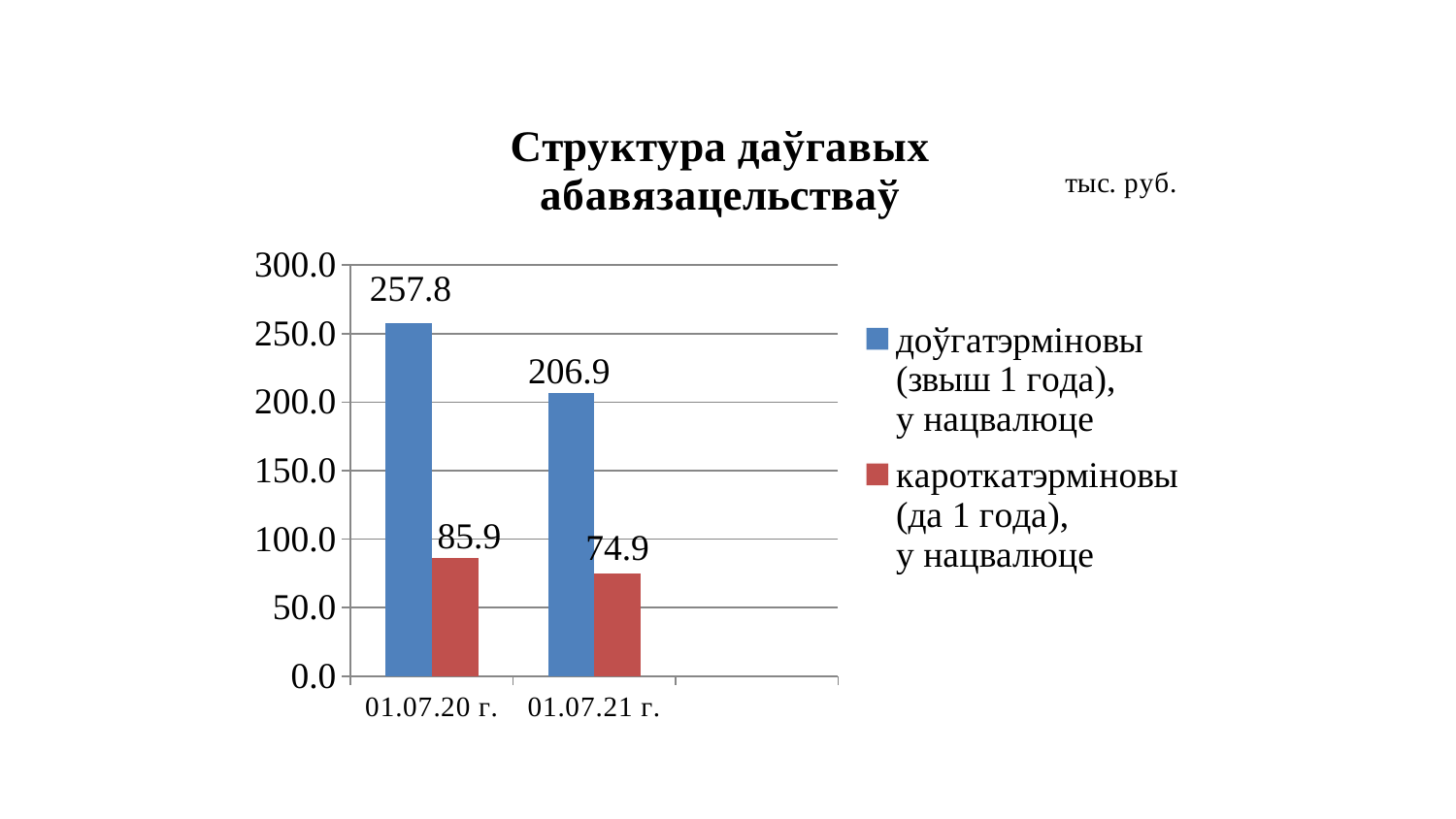
What kind of chart is shown on the slide? Bar chart What is the value of the short-term (кароткатэрміновы) series for 01.07.20 г.? 85.9 What unit is indicated next to the chart title? тыс. руб. Which date has the highest value for the long-term (доўгатэрміновы) series? 01.07.20 г. How many dates (categories) are shown on the x axis? 2 What is the difference between the long-term values for 01.07.20 г. and 01.07.21 г.? 50.9 How many series does the legend list? 2 What is the value of the long-term (доўгатэрміновы) series for 01.07.20 г.? 257.8 What is the value of the short-term (кароткатэрміновы) series for 01.07.21 г.? 74.9 What is the value of the long-term (доўгатэрміновы) series for 01.07.21 г.? 206.9 Which is larger: the short-term value for 01.07.20 г. or for 01.07.21 г.? 01.07.20 г. Which date has the lowest value for the short-term (кароткатэрміновы) series? 01.07.21 г.